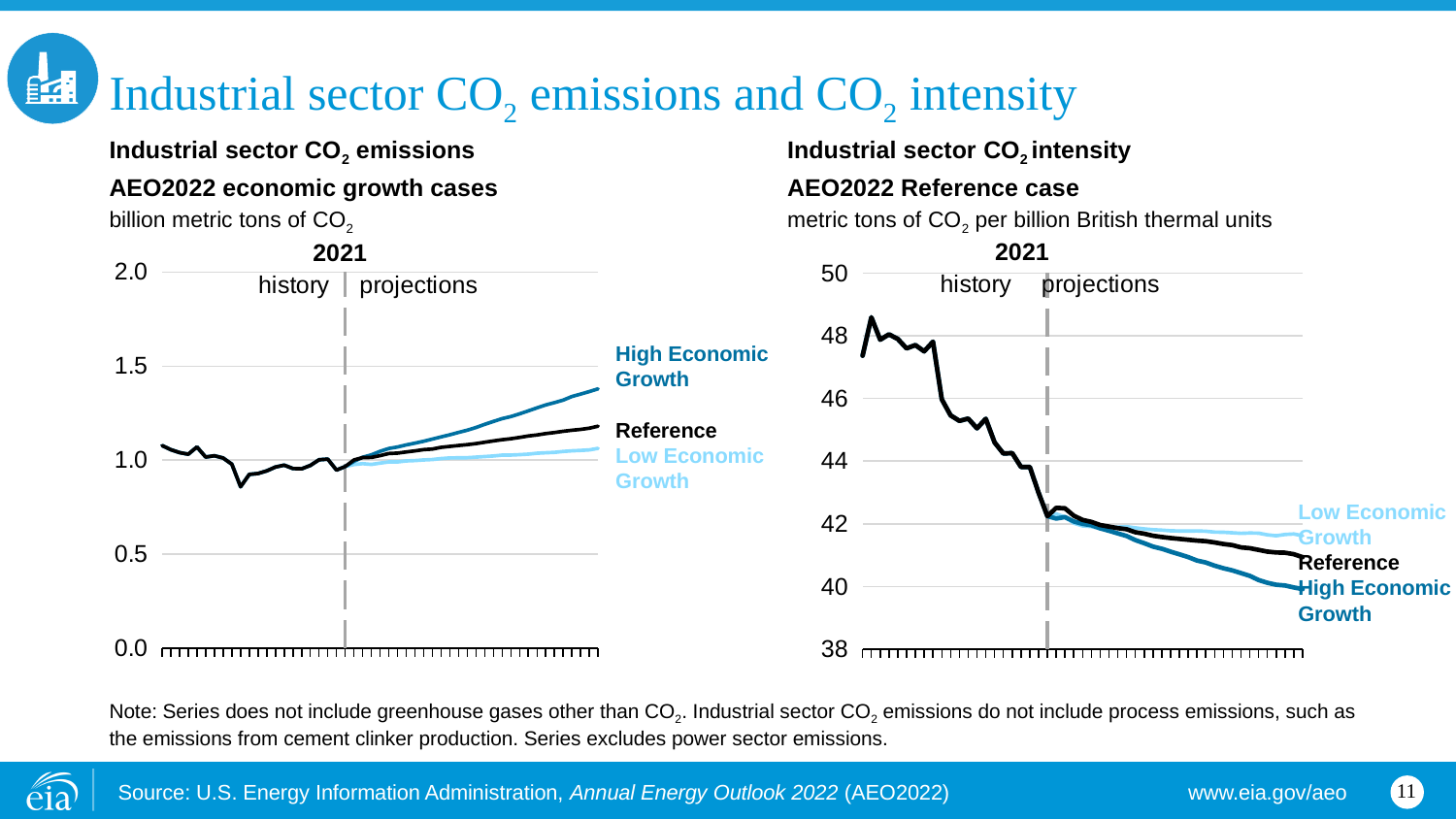
In the left chart (Industrial sector CO2 emissions), is the Reference value at the end of the projections greater or less than 1.0? greater In the left chart (Industrial sector CO2 emissions), is the High Economic Growth value at the end of the projections greater or less than 1.5? less In the right chart (Industrial sector CO2 intensity), is the Low Economic Growth value at the end of the projections greater or less than 40? greater In the right chart (Industrial sector CO2 intensity), which series has the lowest value at the end of the projection period? High Economic Growth In the right chart (Industrial sector CO2 intensity), does the value generally rise or fall from the start of history to the end of the projections? fall In the left chart (Industrial sector CO2 emissions), which series has the highest value at the end of the projection period? High Economic Growth What kind of chart is the 'Industrial sector CO2 intensity' chart on the right? line chart What kind of chart is the 'Industrial sector CO2 emissions' chart on the left? line chart What unit is shown on the y axis of the right chart (Industrial sector CO2 intensity)? metric tons of CO2 per billion British thermal units In the left chart (Industrial sector CO2 emissions), how many projection series are labelled? 3